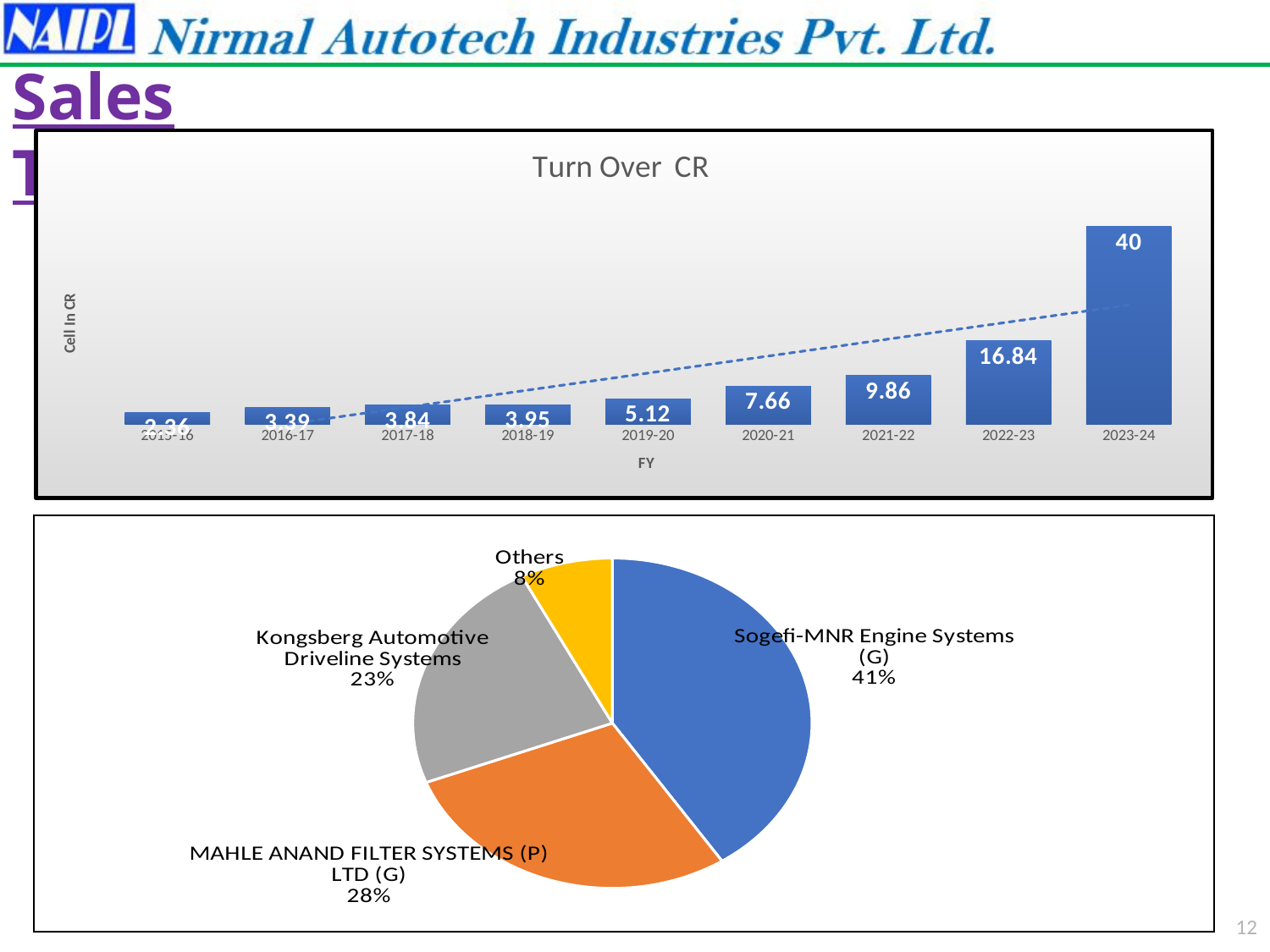
In the pie chart at the bottom of the slide, how many slices are there? 4 In the 'Turn Over CR' bar chart, what is the difference between the values for 2023-24 and 2022-23? 23.16 In the 'Turn Over CR' chart, do the values rise or fall from 2016-17 to 2023-24? rise In the 'Turn Over CR' bar chart, how many fiscal years are shown on the x axis? 9 In the 'Turn Over CR' bar chart, what is the value for 2022-23? 16.84 In the 'Turn Over CR' bar chart, which is larger, the value for 2020-21 or the value for 2021-22? 2021-22 In the pie chart at the bottom of the slide, what share does Sogefi-MNR Engine Systems (G) have? 41% In the 'Turn Over CR' bar chart, what is the value for 2019-20? 5.12 In the 'Turn Over CR' bar chart, which fiscal year has the highest turnover? 2023-24 In the pie chart at the bottom of the slide, which customer has the smallest share? Others In the 'Turn Over CR' bar chart, what is the value for 2023-24? 40 What kind of chart is the 'Turn Over CR' chart at the top of the slide? bar chart